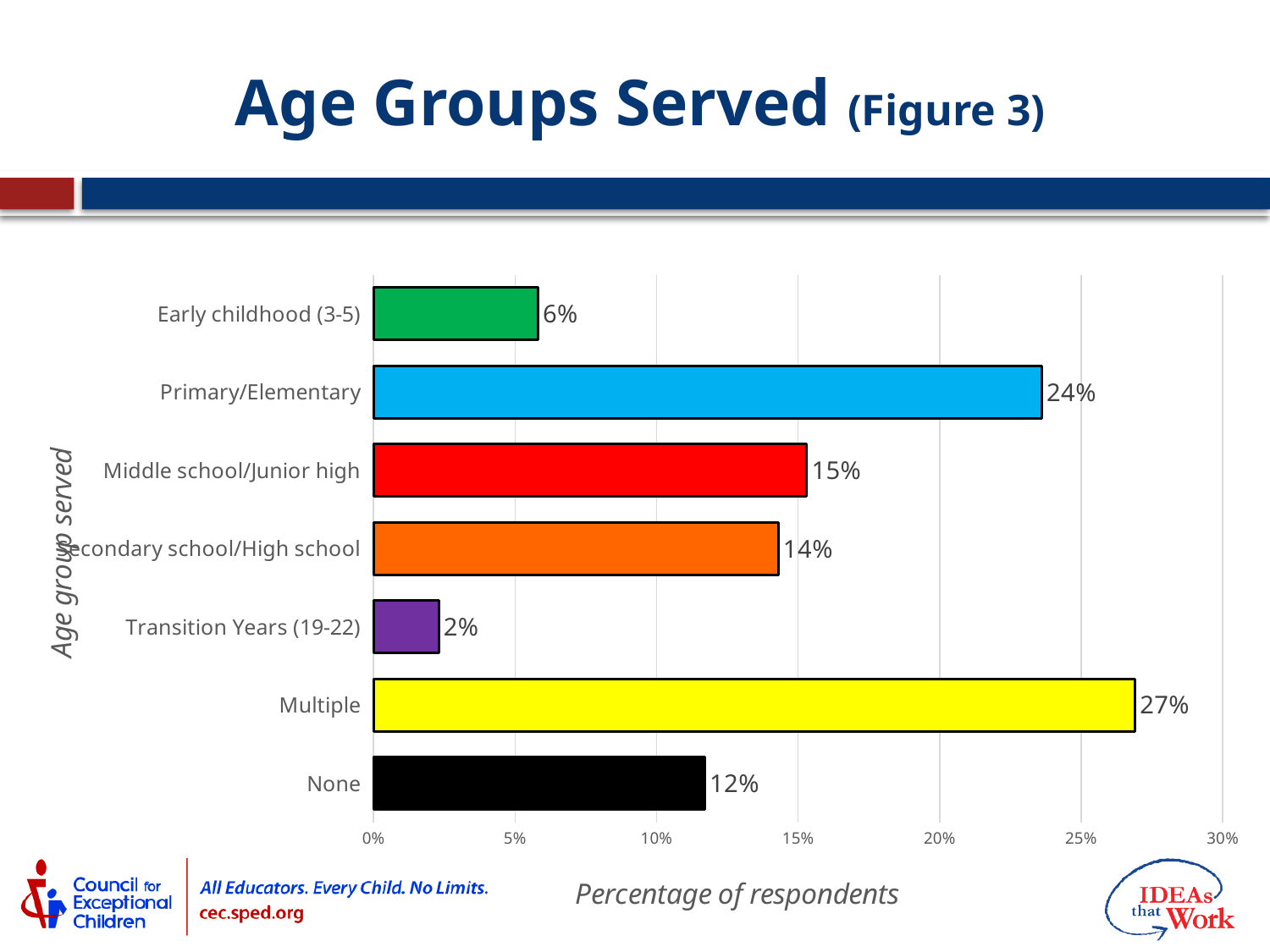
What is the difference between the percentages for Middle school/Junior high and Early childhood (3-5)? 9% Which age group category has the lowest percentage of respondents? Transition Years (19-22) What percentage of respondents reported serving None of the age groups? 12% Is the value for Primary/Elementary greater or less than 20%? greater What is the value for Transition Years (19-22)? 2% What is the difference between the percentages for Multiple and Primary/Elementary? 3% What is the label of the horizontal axis? Percentage of respondents What kind of chart is shown on the slide? Bar chart Which age group category has the highest percentage of respondents? Multiple How many age group categories are shown on the chart? 7 What percentage of respondents serve the Primary/Elementary age group? 24% Which is larger, the value for Secondary school/High school or the value for None? Secondary school/High school